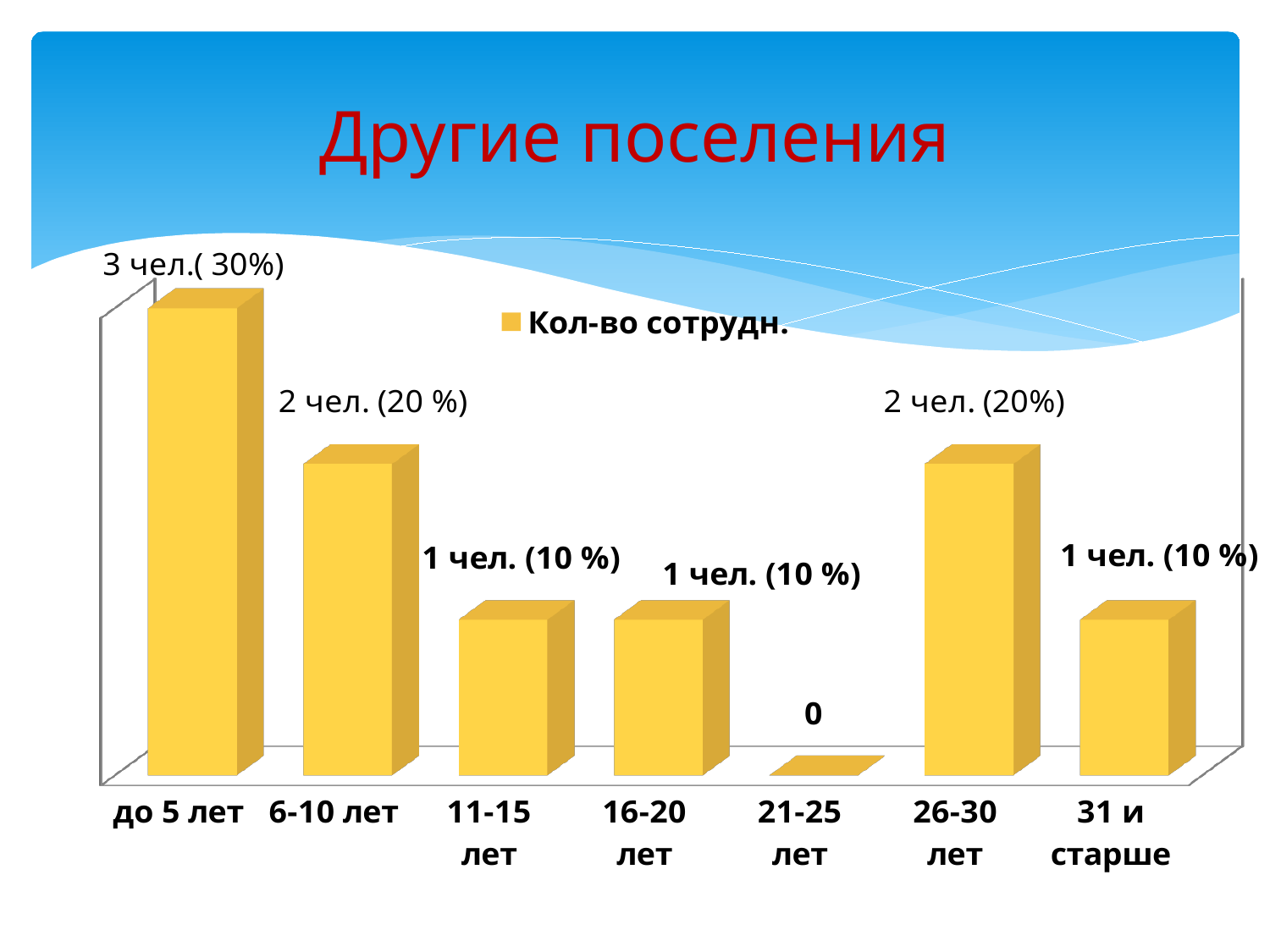
Which category has the highest value? до 5 лет What is the data label for the 'до 5 лет' category? 3 чел.( 30%) How many series does the legend list? 1 What is the difference in number of people between 'до 5 лет' and '31 и старше'? 2 чел. What is the data label for the '6-10 лет' category? 2 чел. (20 %) Which is larger, the value for '6-10 лет' or the value for '11-15 лет'? 6-10 лет What kind of chart is shown on the slide? bar chart What is the title of the chart? Другие поселения Which category has the lowest value? 21-25 лет What is the data label for the '21-25 лет' category? 0 How many categories are shown on the x axis? 7 What is the data label for the '26-30 лет' category? 2 чел. (20%)